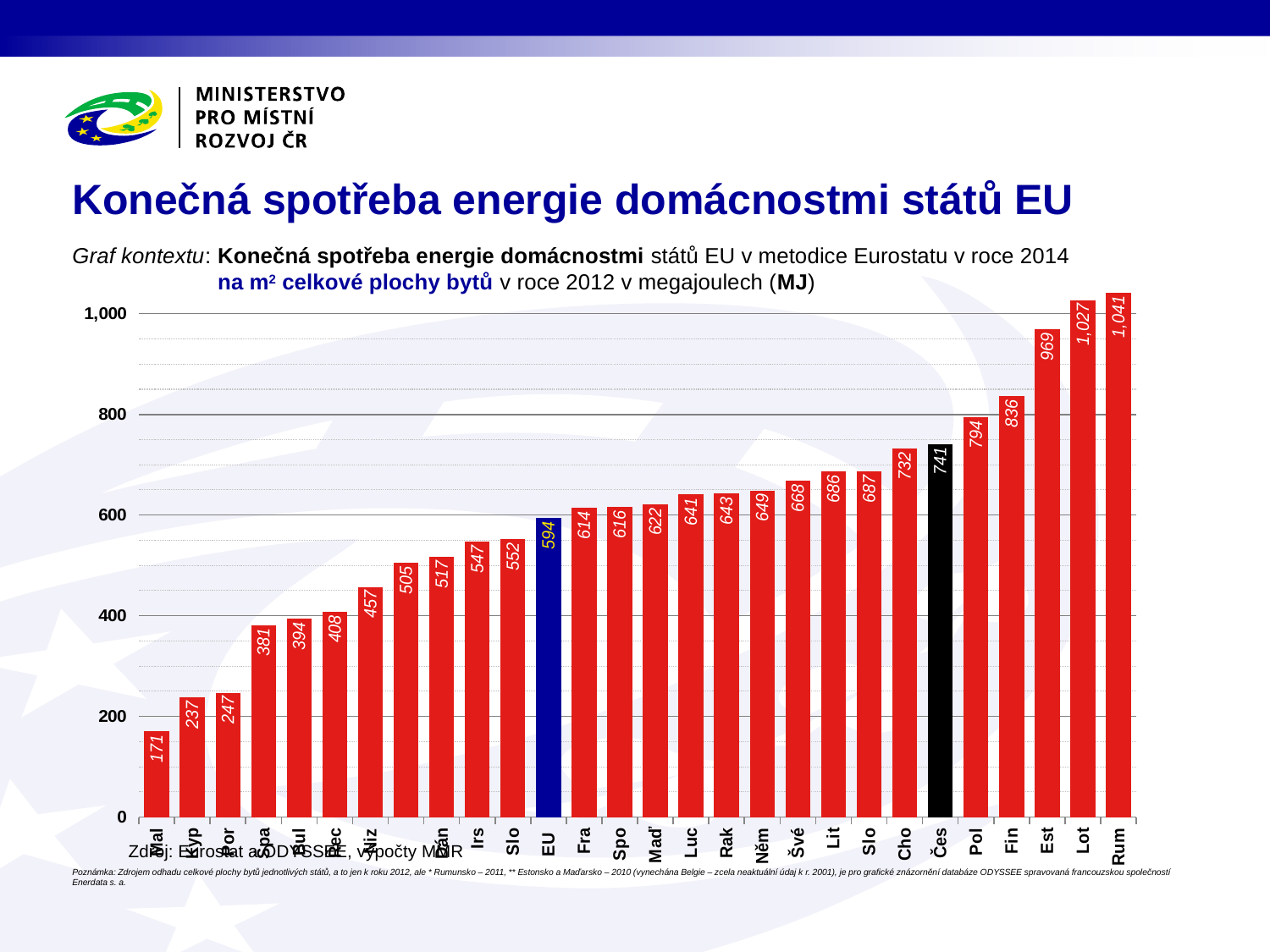
What is the value for Něm? 649 What is the difference between the values for Rum and Lot? 14 What is the value for Rum? 1,041 What is the value for EU? 594 What is the difference between the values for Čes and EU? 147 Which category has the highest value? Rum What kind of chart is shown? bar chart How many bars are plotted in the chart? 28 What is the value for Fin? 836 What is the value for Čes? 741 Which is larger, the value for Pol or the value for Fin? Fin Do the values rise or fall from left to right along the x axis? rise